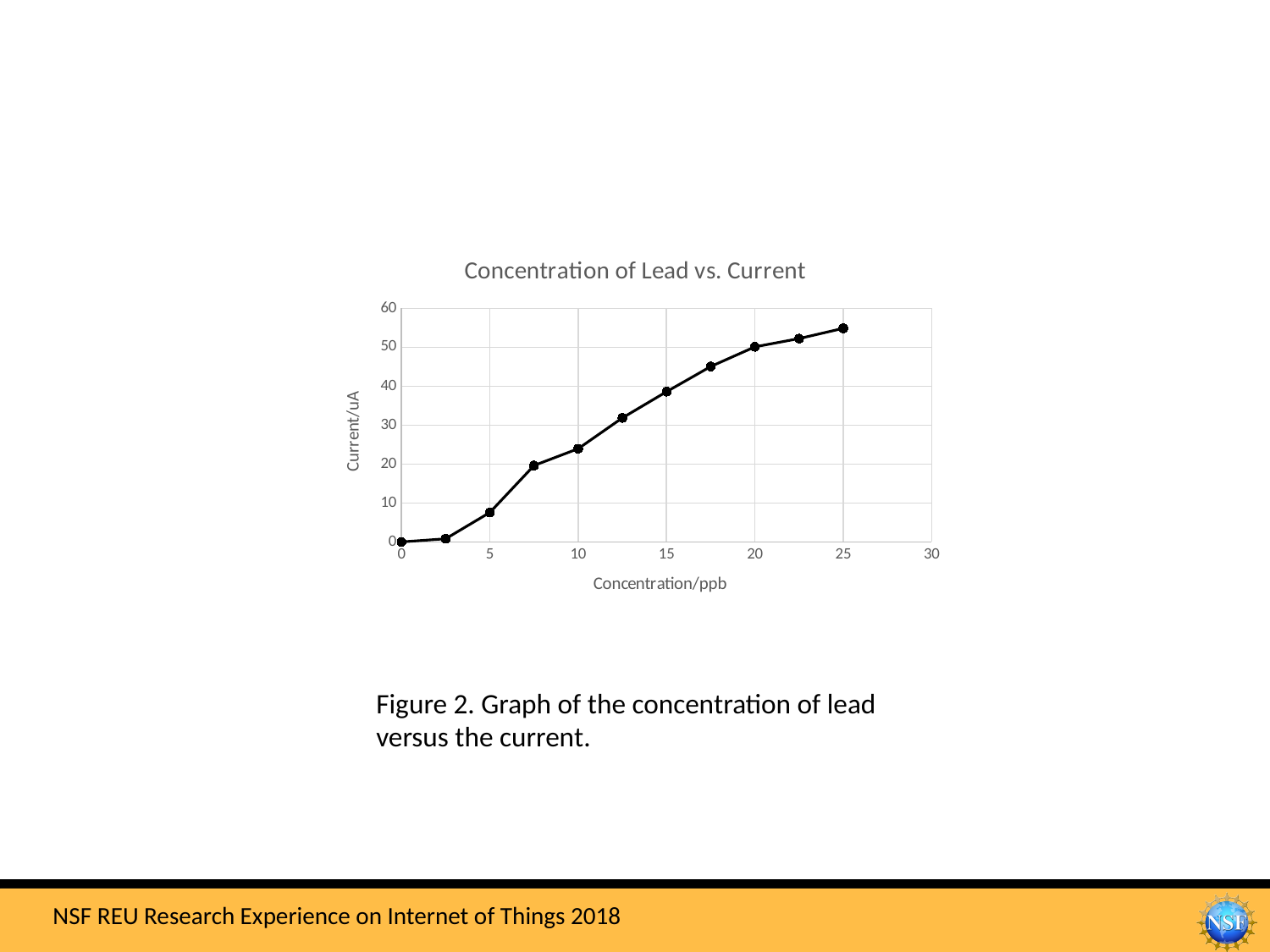
What is the title of the chart? Concentration of Lead vs. Current At which concentration is the current lowest? 0 ppb Which has the higher current, 10 ppb or 15 ppb? 15 ppb What is the label of the y axis? Current/uA Is the current at 5 ppb greater or less than 10? less What kind of chart is shown on the slide? line chart Does the current rise or fall as concentration increases along the x axis? rises At which concentration is the current highest? 25 ppb What is the current at a concentration of 0 ppb? 0 Is the current at 15 ppb greater or less than 30? greater Is the current at 25 ppb greater or less than 50? greater How many data points are plotted on the line? 11